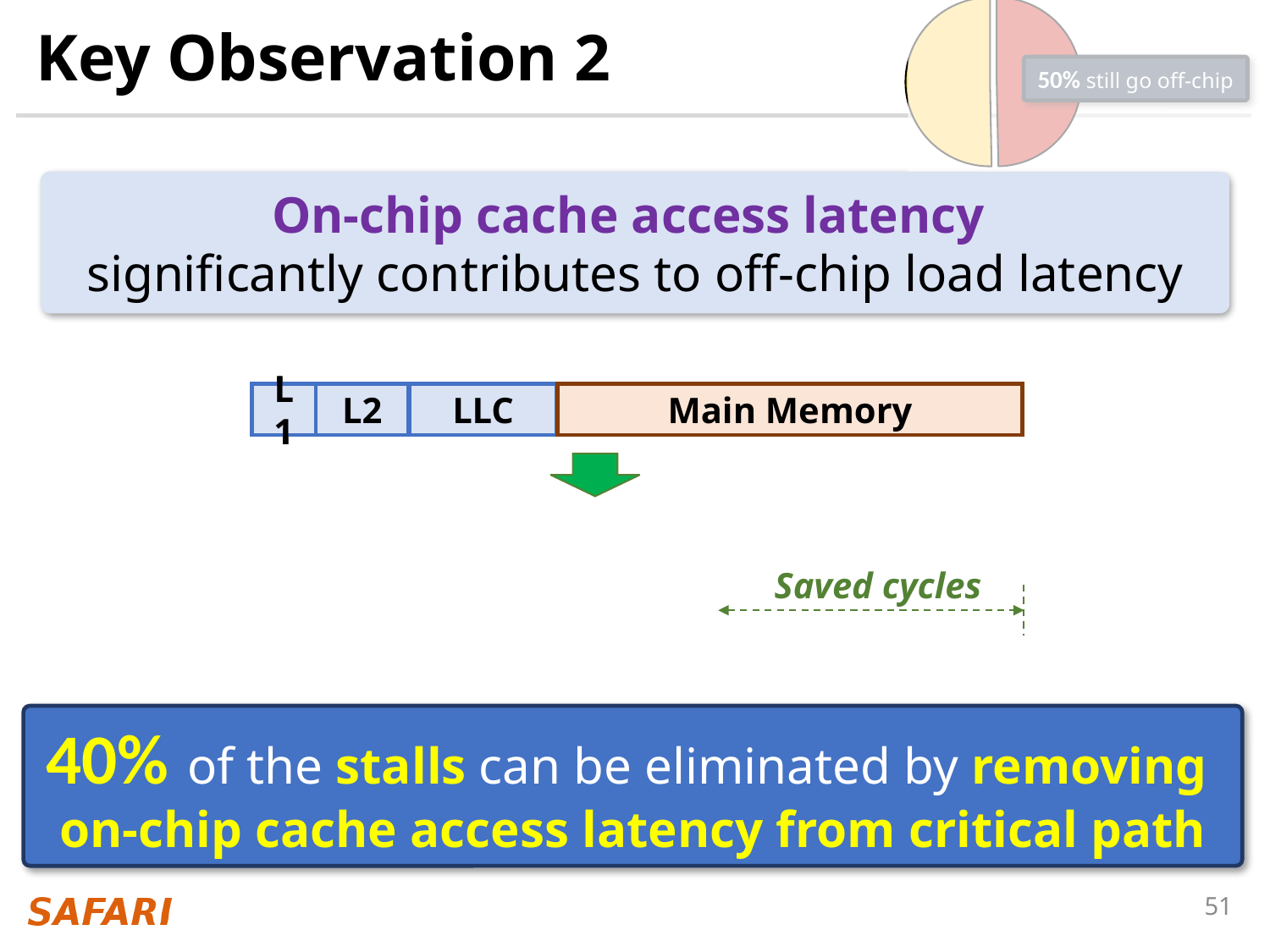
In the pie chart at the top right, what share is labelled as still going off-chip? 50% In the pie chart at the top right, what colour is the slice labelled '50% still go off-chip'? red What kind of chart is shown in the top right corner of the slide? pie chart What text is shown in the label attached to the pie chart at the top right of the slide? 50% still go off-chip How many slices does the pie chart at the top right of the slide have? 2